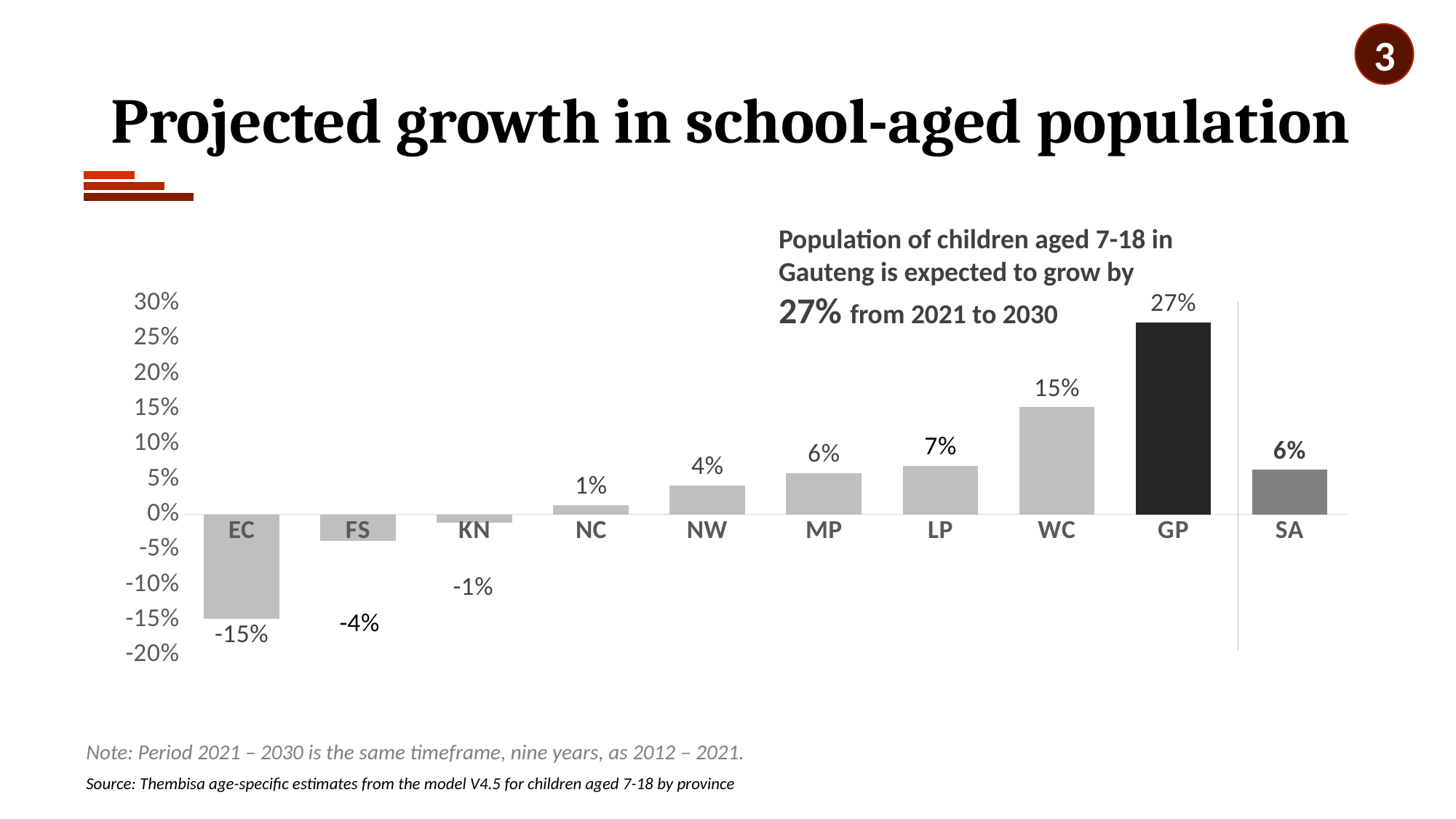
What is the value for FS? -4% What is the projected growth value for EC? -15% What kind of chart is shown on the slide? Bar chart Which has a larger value, LP or MP? LP What is the projected growth value for GP? 27% What is the projected growth value for SA? 6% What is the projected growth value for WC? 15% Which province has the lowest projected growth? EC Which bar is coloured black? GP How many categories are shown on the x axis? 10 What is the difference between the values for GP and WC? 12% Which province has the highest projected growth? GP